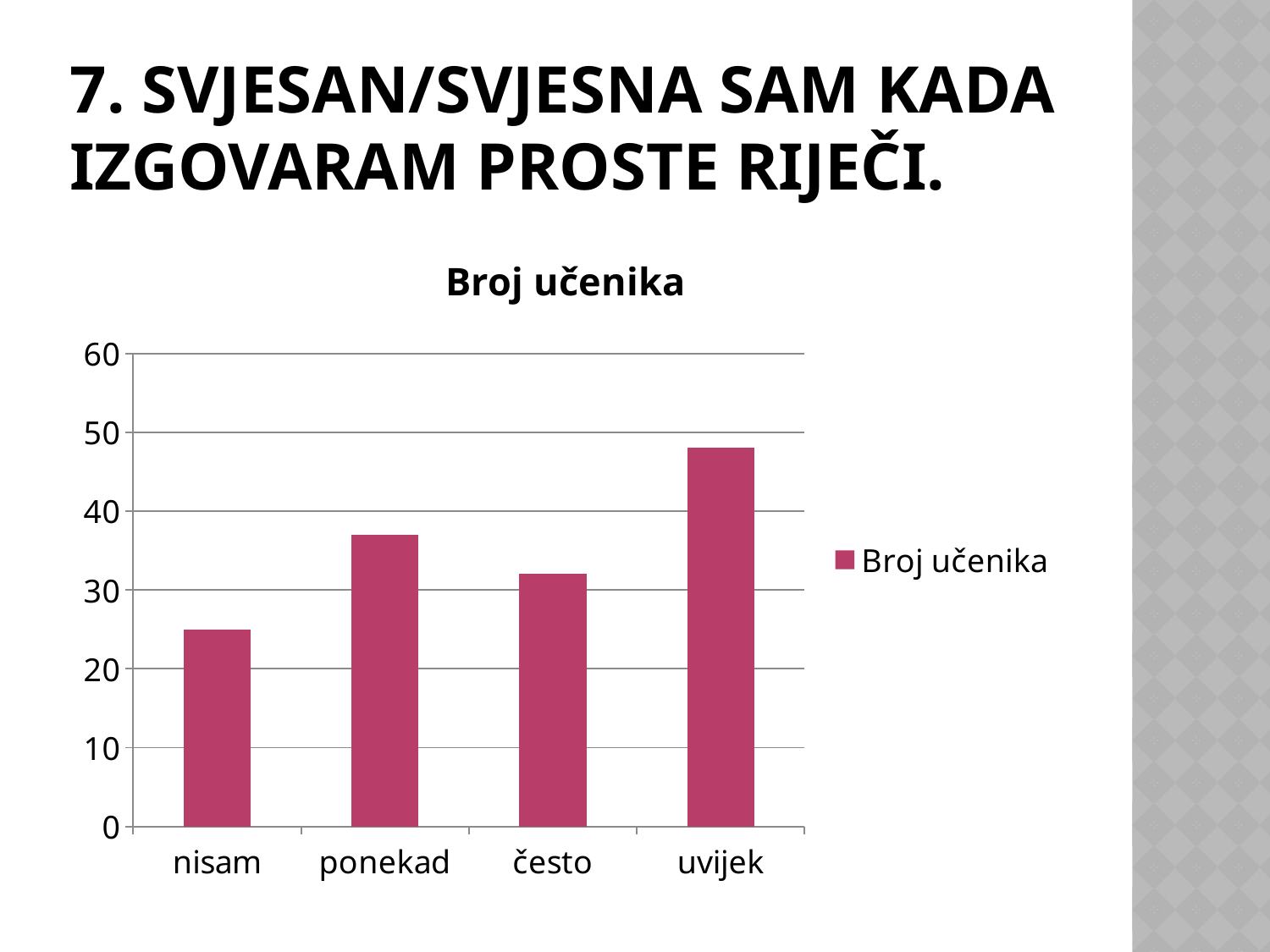
Is the value for nisam greater or less than 20? greater What is the title of the chart? Broj učenika Which category has the highest value? uvijek Is the value for uvijek greater or less than 50? less How many categories are shown on the x axis of the chart? 4 Is the value for ponekad greater or less than 40? less How many series does the legend list? 1 What kind of chart is shown on the slide? bar chart Which is larger, the value for ponekad or the value for često? ponekad Which category has the lowest value? nisam